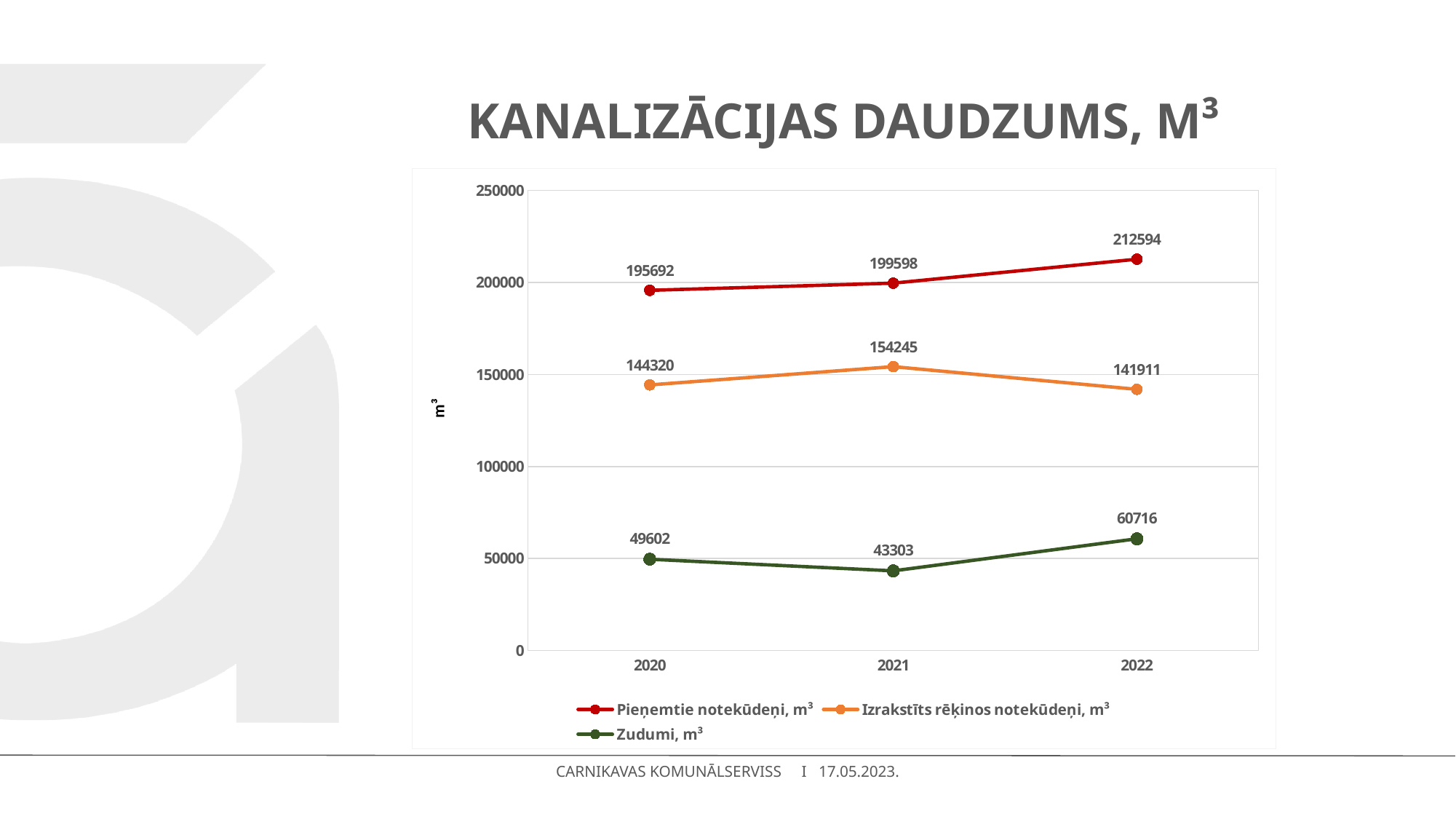
What is the value of Izrakstīts rēķinos notekūdeņi, m³ in 2021? 154245 In which year is Zudumi, m³ lowest? 2021 What is the title of the chart? KANALIZĀCIJAS DAUDZUMS, M³ Does Pieņemtie notekūdeņi, m³ rise or fall from 2020 to 2022? rise What is the value of Pieņemtie notekūdeņi, m³ in 2022? 212594 What is the value of Zudumi, m³ in 2020? 49602 Which is larger: Izrakstīts rēķinos notekūdeņi, m³ in 2020 or in 2022? 2020 How many series does the legend list? 3 What type of chart is shown on the slide? line chart In which year is Pieņemtie notekūdeņi, m³ highest? 2022 How many years are shown on the x axis? 3 What is the difference between Pieņemtie notekūdeņi, m³ and Izrakstīts rēķinos notekūdeņi, m³ in 2020? 51372